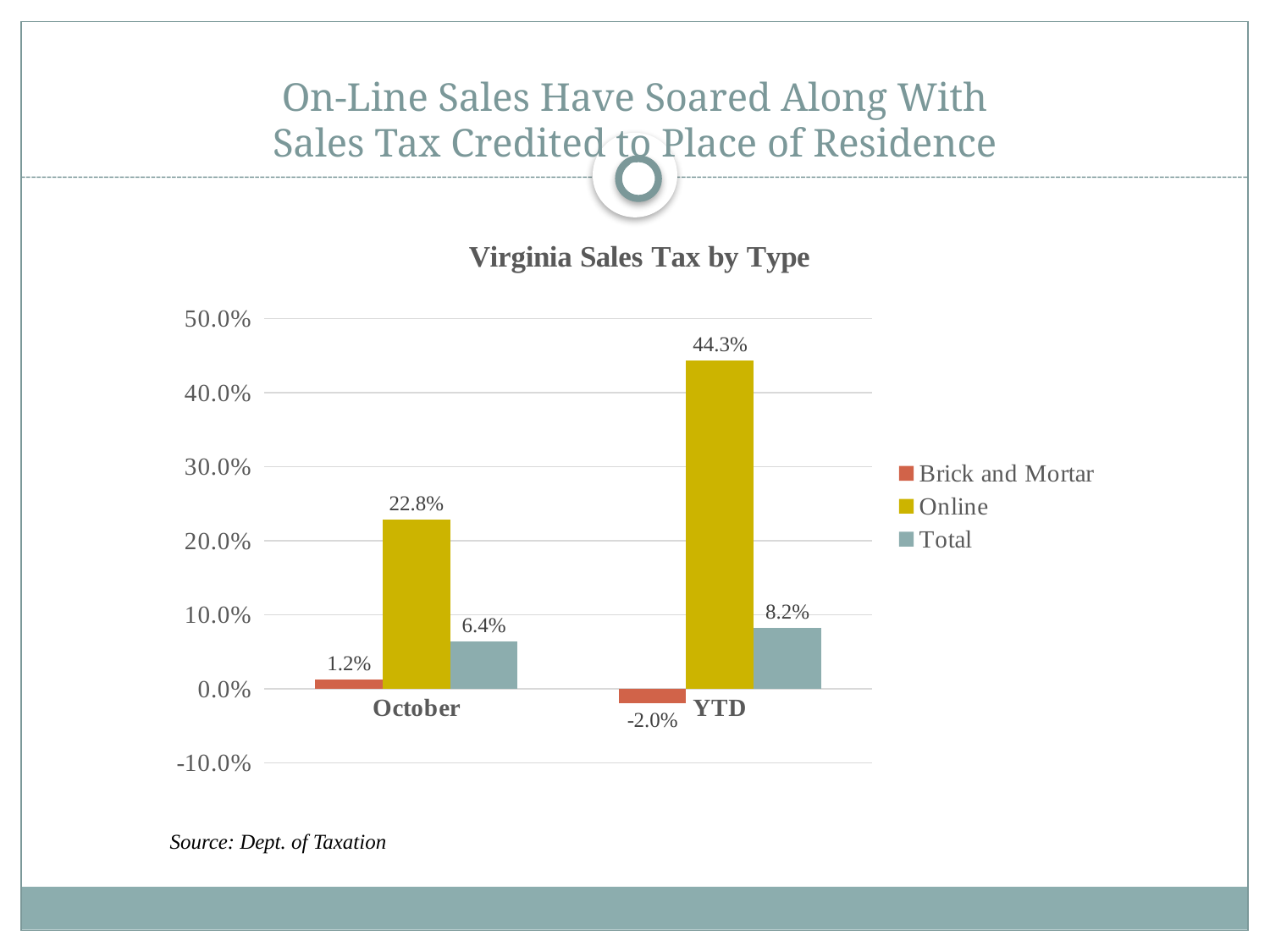
How many series does the legend list? 3 What is the Brick and Mortar value for YTD? -2.0% What kind of chart is shown on the slide? bar chart What is the Total value for October? 6.4% Which series has the highest value for YTD? Online Which series has the lowest value for October? Brick and Mortar Which is larger, the Total value for October or the Total value for YTD? YTD What is the Online value for October? 22.8% Is the Online value for YTD greater or less than 40.0%? greater How many categories are shown on the x axis? 2 What is the difference between the Online values for YTD and October? 21.5% What is the Online value for YTD? 44.3%